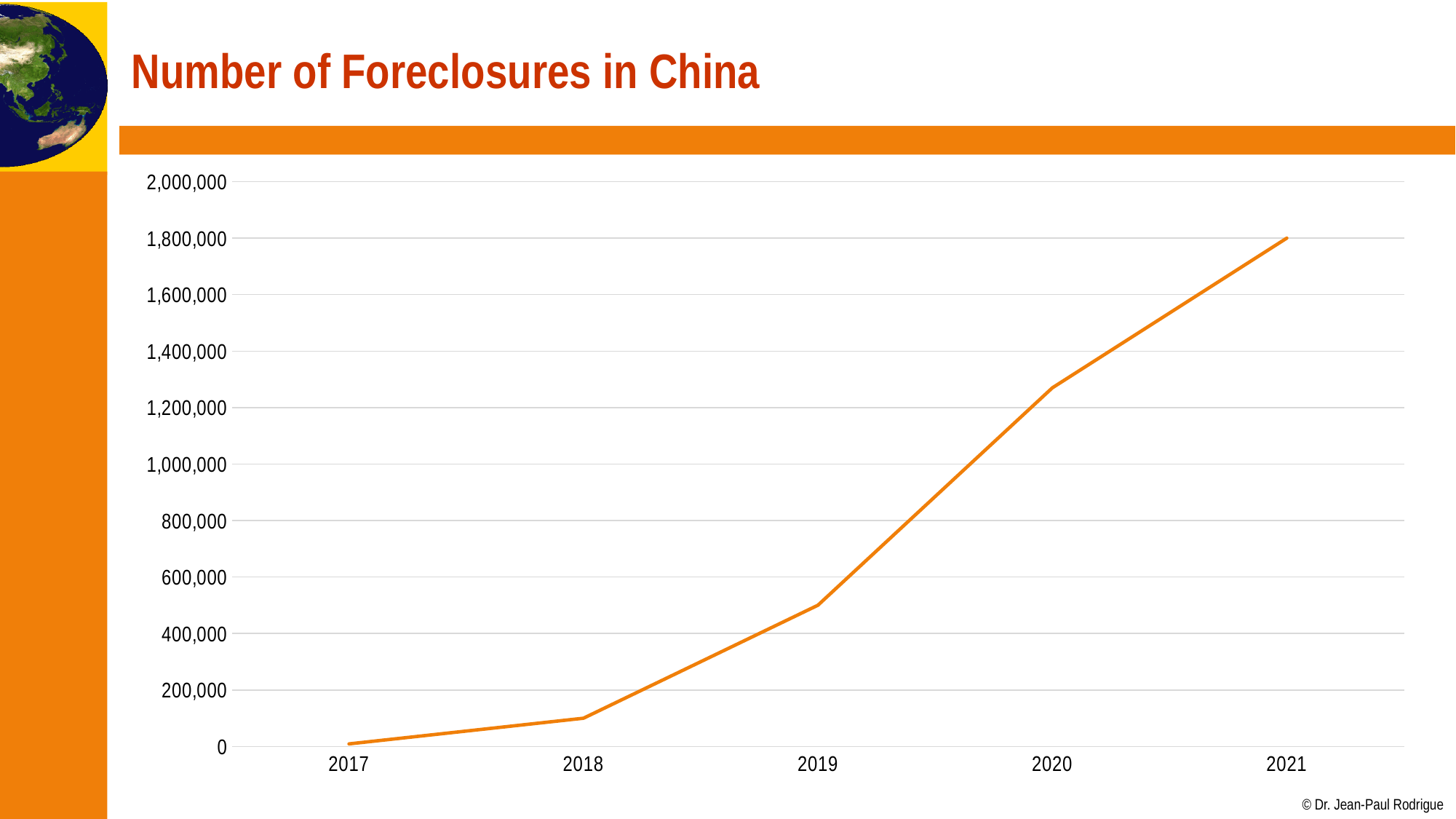
Is the value for 2021 greater or less than 1,600,000? greater What is the highest value shown on the y axis? 2,000,000 What kind of chart is shown on the slide? line chart What is the title of the chart? Number of Foreclosures in China Do the values rise or fall from 2017 to 2021? rise Is the value for 2018 greater or less than 200,000? less Is the value for 2019 greater or less than 600,000? less Which year has more foreclosures, 2019 or 2020? 2020 Which year has the lowest number of foreclosures? 2017 How many years are plotted on the x axis? 5 Which year has the highest number of foreclosures? 2021